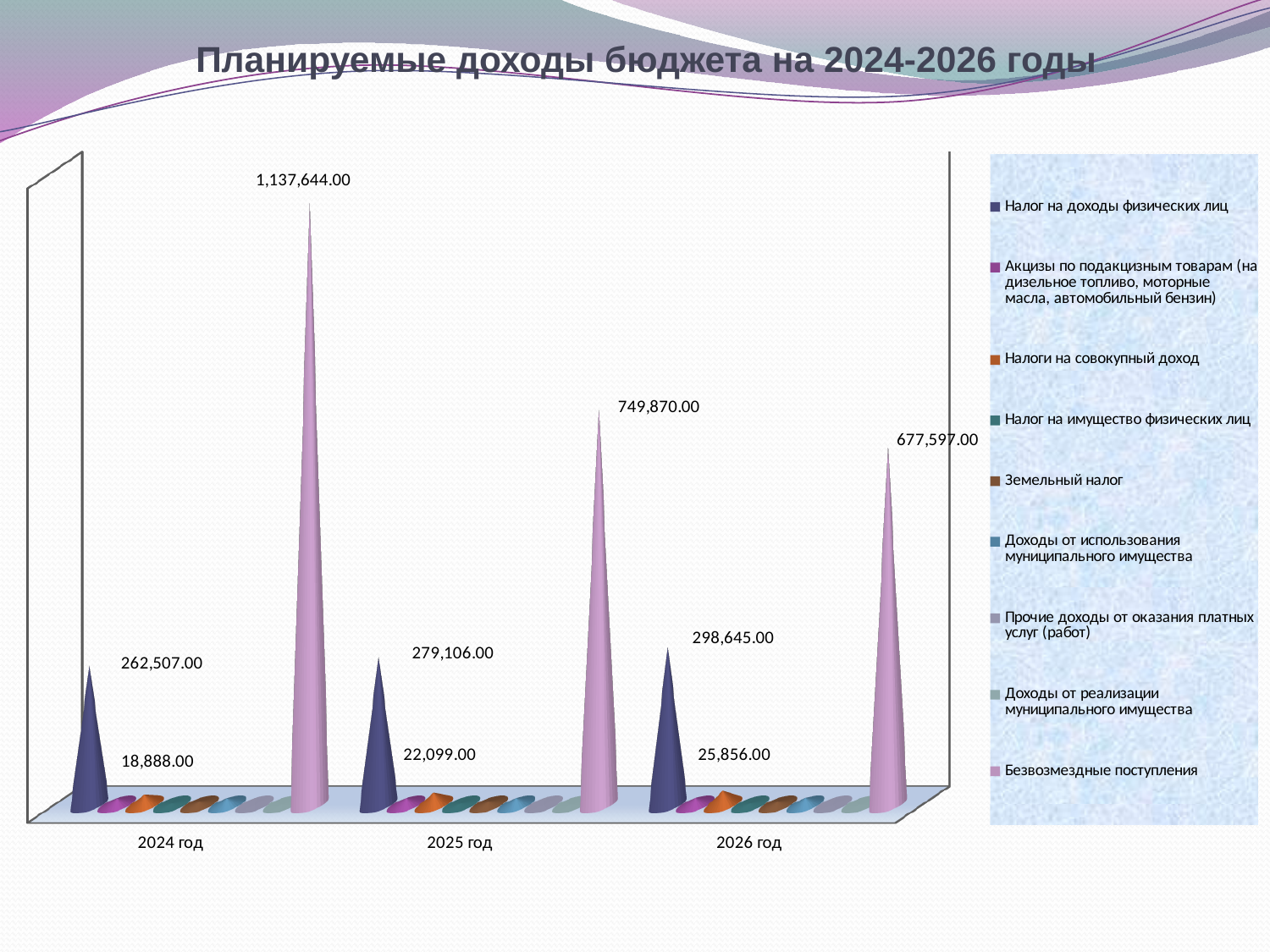
What is the value of Налог на доходы физических лиц for 2025 год? 279,106.00 What is the value of Безвозмездные поступления for 2025 год? 749,870.00 What is the difference between Безвозмездные поступления in 2024 год and 2025 год? 387,774.00 In which year is Налог на доходы физических лиц lowest? 2024 год What is the value of Налог на доходы физических лиц for 2026 год? 298,645.00 How many years are shown on the x axis? 3 In which year is Безвозмездные поступления highest? 2024 год How many series does the legend list? 9 Which is larger: Безвозмездные поступления in 2026 год or Налог на доходы физических лиц in 2026 год? Безвозмездные поступления in 2026 год What is the value of Безвозмездные поступления for 2024 год? 1,137,644.00 What kind of chart is shown on the slide? 3D bar chart Does Безвозмездные поступления rise or fall from 2024 год to 2026 год? fall